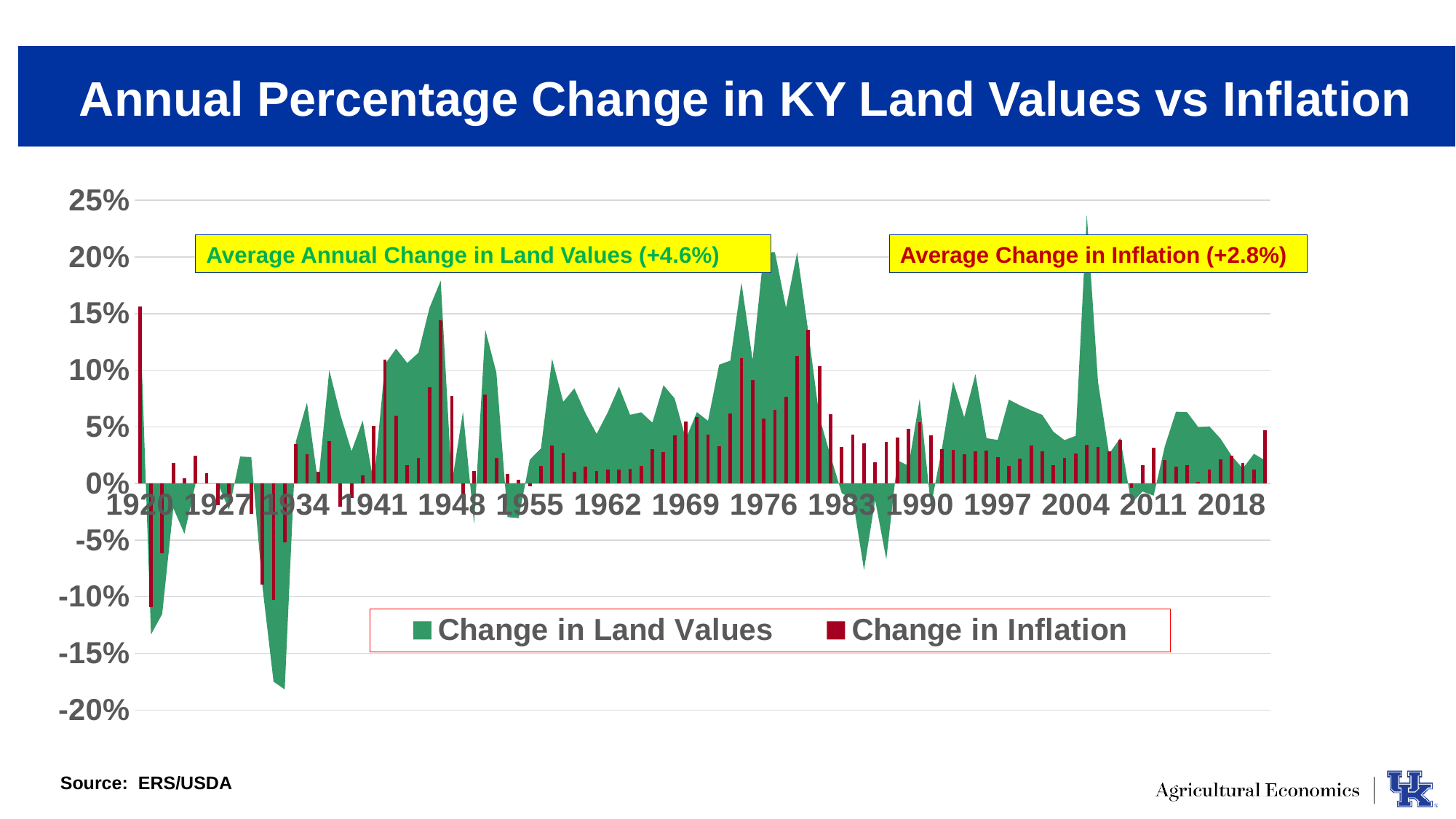
Is the value for Change in Inflation in 1920 greater or less than 10%? greater What is the first year labelled on the x axis? 1920 Is the peak value for Change in Land Values around 2005 greater or less than 20%? greater What kind of chart is this? Combined area and bar chart How many series does the legend list? 2 Which is larger, the average annual change in land values or the average change in inflation? Average annual change in land values Which series is shown in green on the chart? Change in Land Values Is the lowest value for Change in Land Values in the early 1930s greater or less than -15%? less What is the title of the chart? Annual Percentage Change in KY Land Values vs Inflation What is the difference between the average annual change in land values (+4.6%) and the average change in inflation (+2.8%)? 1.8% What is the average change in inflation shown on the chart? +2.8% What is the average annual change in land values shown on the chart? +4.6%